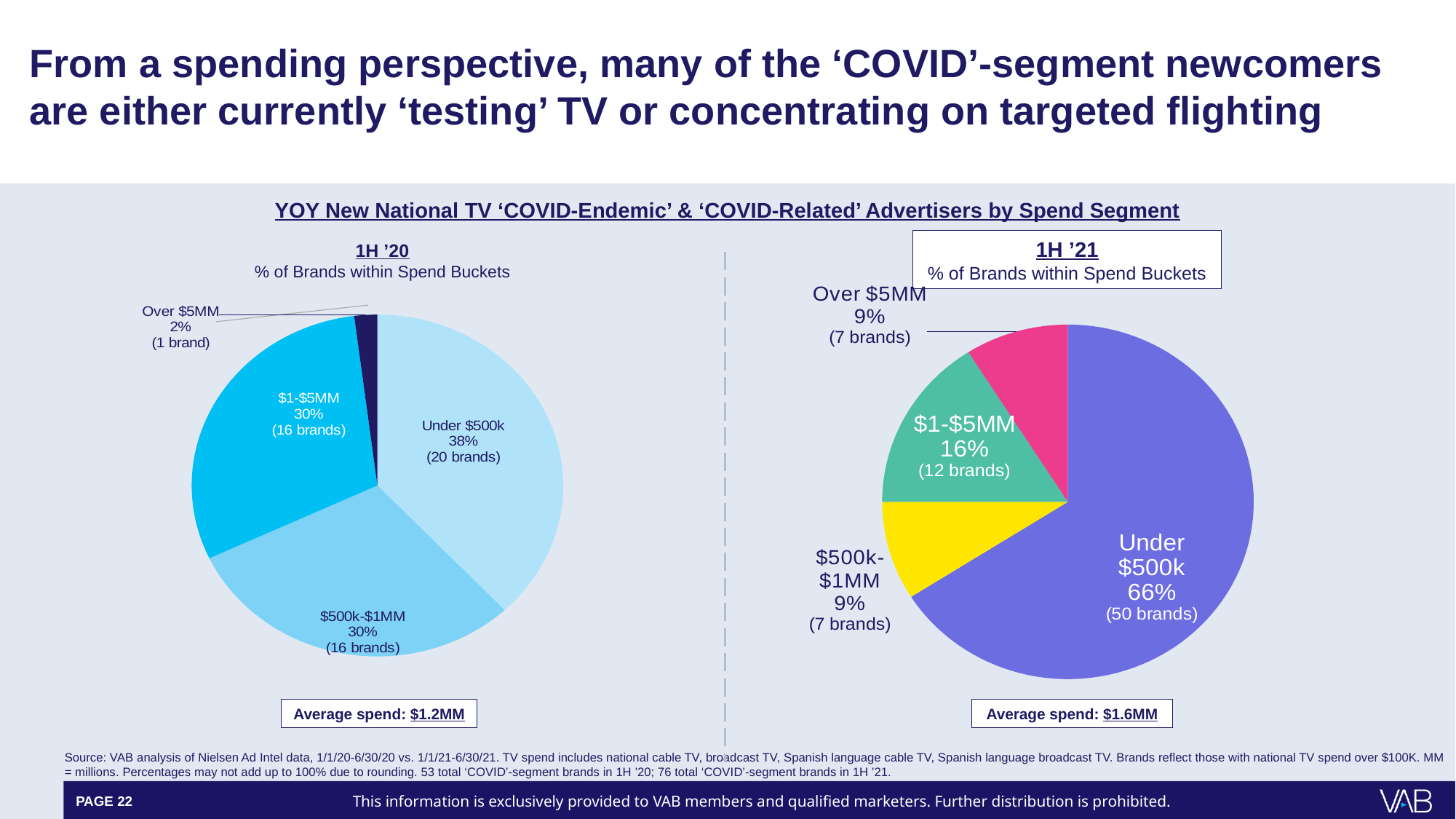
What is the average spend shown below the 1H '21 pie chart? $1.6MM What type of chart is used to show the 1H '20 brands by spend bucket? Pie chart In the 1H '21 pie chart, which spend bucket has the largest share of brands? Under $500k What is the difference in percentage points between the Under $500k share in the 1H '21 chart and the Under $500k share in the 1H '20 chart? 28 percentage points In the 1H '21 pie chart, how many brands are in the Under $500k spend bucket? 50 brands In the 1H '20 pie chart, how many brands are in the Over $5MM spend bucket? 1 brand Which is larger: the $1-$5MM share in the 1H '20 chart or the $1-$5MM share in the 1H '21 chart? 1H '20 In the 1H '21 pie chart, what share of brands is in the $1-$5MM spend bucket? 16% In the 1H '20 pie chart, which spend bucket has the smallest share of brands? Over $5MM In the 1H '21 pie chart, what share of brands is in the Over $5MM spend bucket? 9% In the 1H '20 pie chart, what share of brands is in the Under $500k spend bucket? 38% How many spend buckets (slices) does the 1H '21 pie chart show? 4